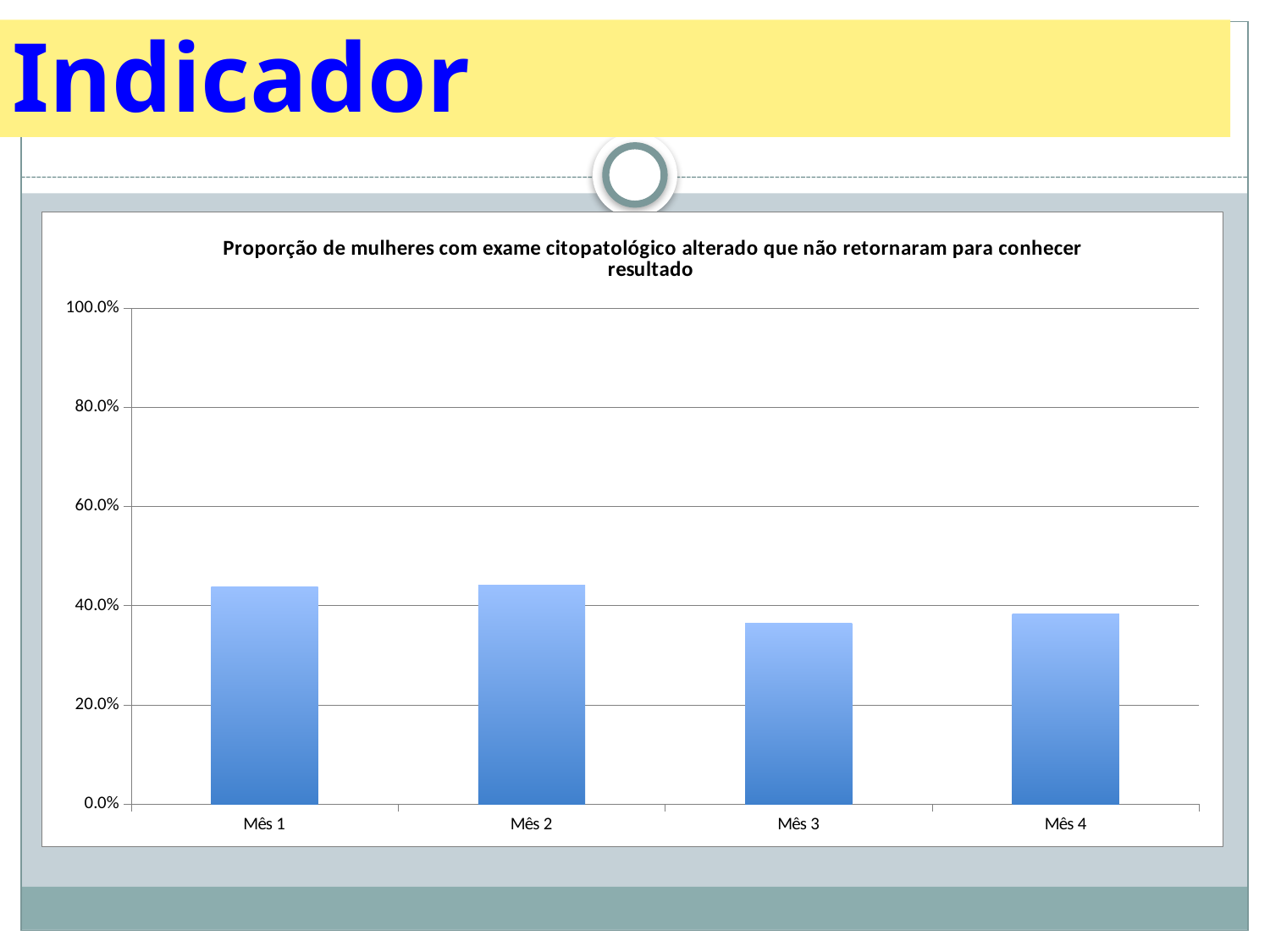
Is the value for Mês 2 greater or less than 60.0%? less Which is larger, the value for Mês 1 or the value for Mês 4? Mês 1 What is the highest value shown on the vertical axis of the chart? 100.0% Which is larger, the value for Mês 2 or the value for Mês 3? Mês 2 Is the value for Mês 3 greater or less than 40.0%? less Which month has the lowest value on the chart? Mês 3 What kind of chart is shown on the slide? bar chart Is the value for Mês 2 greater or less than 40.0%? greater What is the title of the chart? Proporção de mulheres com exame citopatológico alterado que não retornaram para conhecer resultado How many categories (months) are plotted on the chart? 4